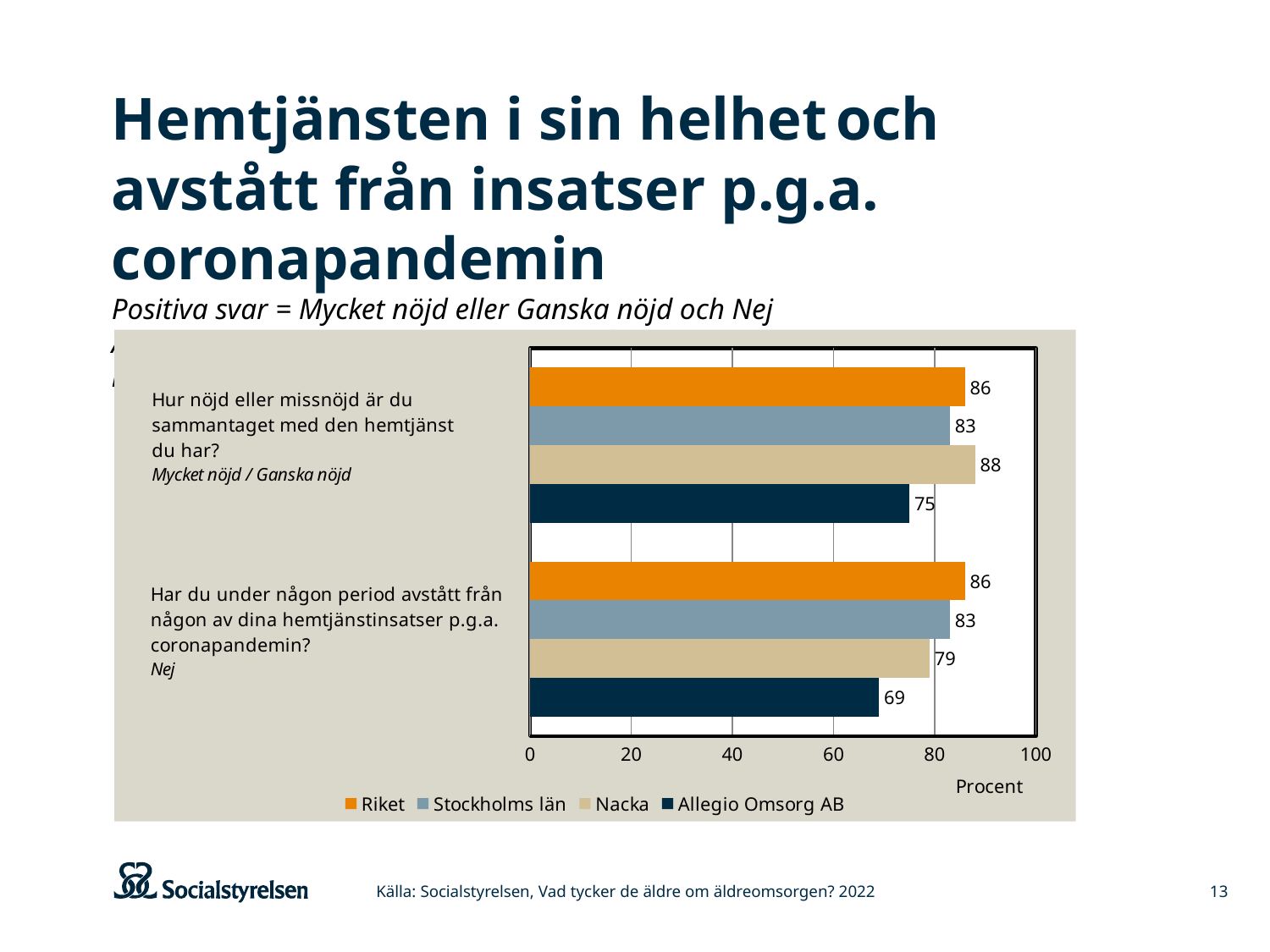
What value is shown for Allegio Omsorg AB on the question "Har du under någon period avstått från någon av dina hemtjänstinsatser p.g.a. coronapandemin?"? 69 Which series has the highest value on the question "Hur nöjd eller missnöjd är du sammantaget med den hemtjänst du har?"? Nacka What kind of chart is shown on the slide? Bar chart What value is shown for Stockholms län on the question "Har du under någon period avstått från någon av dina hemtjänstinsatser p.g.a. coronapandemin?"? 83 How many series does the legend list? 4 What is the difference between the Riket value and the Allegio Omsorg AB value on the question "Har du under någon period avstått från någon av dina hemtjänstinsatser p.g.a. coronapandemin?"? 17 What value is shown for Riket on the question "Hur nöjd eller missnöjd är du sammantaget med den hemtjänst du har?"? 86 What is the difference between the Nacka value and the Allegio Omsorg AB value on the question "Hur nöjd eller missnöjd är du sammantaget med den hemtjänst du har?"? 13 What unit label is shown on the horizontal axis of the chart? Procent What value is shown for Nacka on the question "Hur nöjd eller missnöjd är du sammantaget med den hemtjänst du har?"? 88 Which is larger on the question "Har du under någon period avstått från någon av dina hemtjänstinsatser p.g.a. coronapandemin?": the value for Nacka or the value for Allegio Omsorg AB? Nacka Which series has the lowest value on the question "Har du under någon period avstått från någon av dina hemtjänstinsatser p.g.a. coronapandemin?"? Allegio Omsorg AB